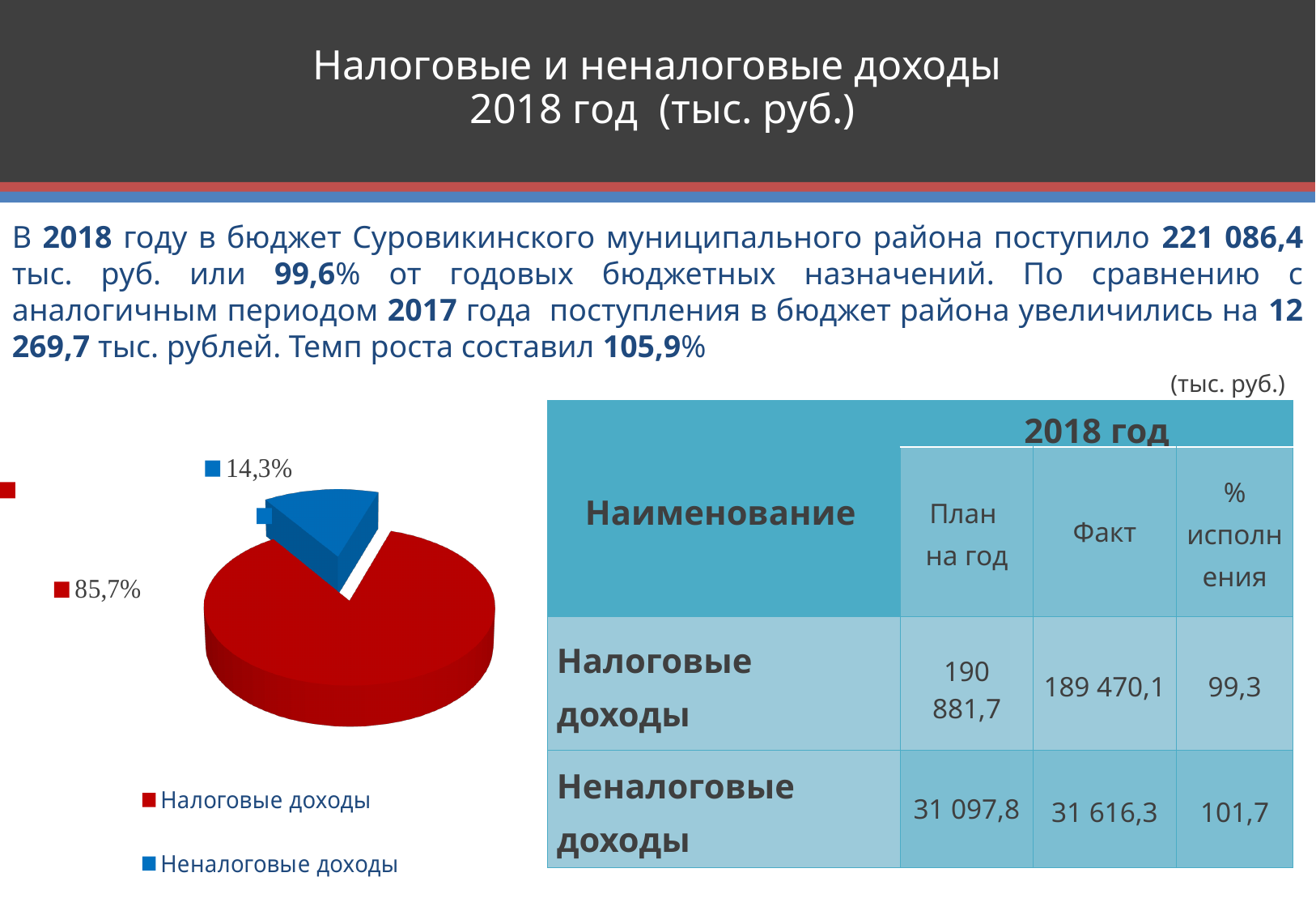
What share of the pie chart does Налоговые доходы represent? 85,7% By how many percentage points does the Налоговые доходы slice exceed the Неналоговые доходы slice? 71,4 What colour is the Налоговые доходы slice in the pie chart? Red Which slice of the pie chart is the smallest? Неналоговые доходы Which is larger in the pie chart, Налоговые доходы or Неналоговые доходы? Налоговые доходы What colour is the Неналоговые доходы slice in the pie chart? Blue How many entries does the legend of the pie chart list? 2 Is the share of Неналоговые доходы in the pie chart greater or less than 20%? less What kind of chart is shown on the slide? Pie chart Which slice of the pie chart is the largest? Налоговые доходы What share of the pie chart does Неналоговые доходы represent? 14,3% How many slices does the pie chart have? 2